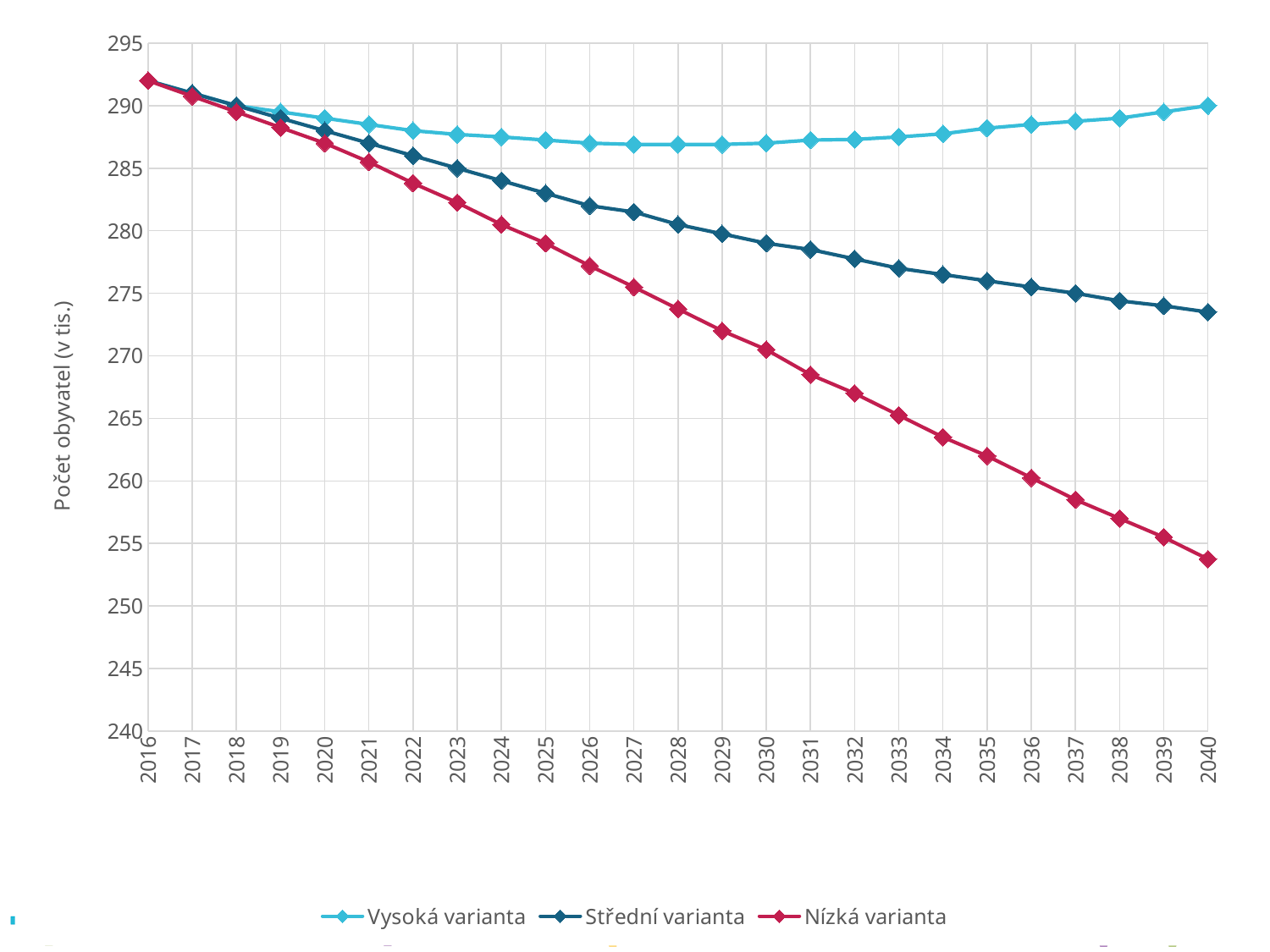
What is the label of the y axis? Počet obyvatel (v tis.) Is the value for Nízká varianta in 2030 greater or less than 275? less In 2040, which is larger: Vysoká varianta or Nízká varianta? Vysoká varianta What kind of chart is shown on the slide? line chart Does the Střední varianta series rise or fall from 2016 to 2040? fall Is the value for Vysoká varianta in 2040 greater or less than 285? greater Which series has the lowest value in 2030? Nízká varianta How many years are plotted along the x axis? 25 Does the Nízká varianta series rise or fall from 2016 to 2040? fall Is the value for Nízká varianta in 2040 greater or less than 255? less How many series does the legend list? 3 Which series has the highest value in 2040? Vysoká varianta